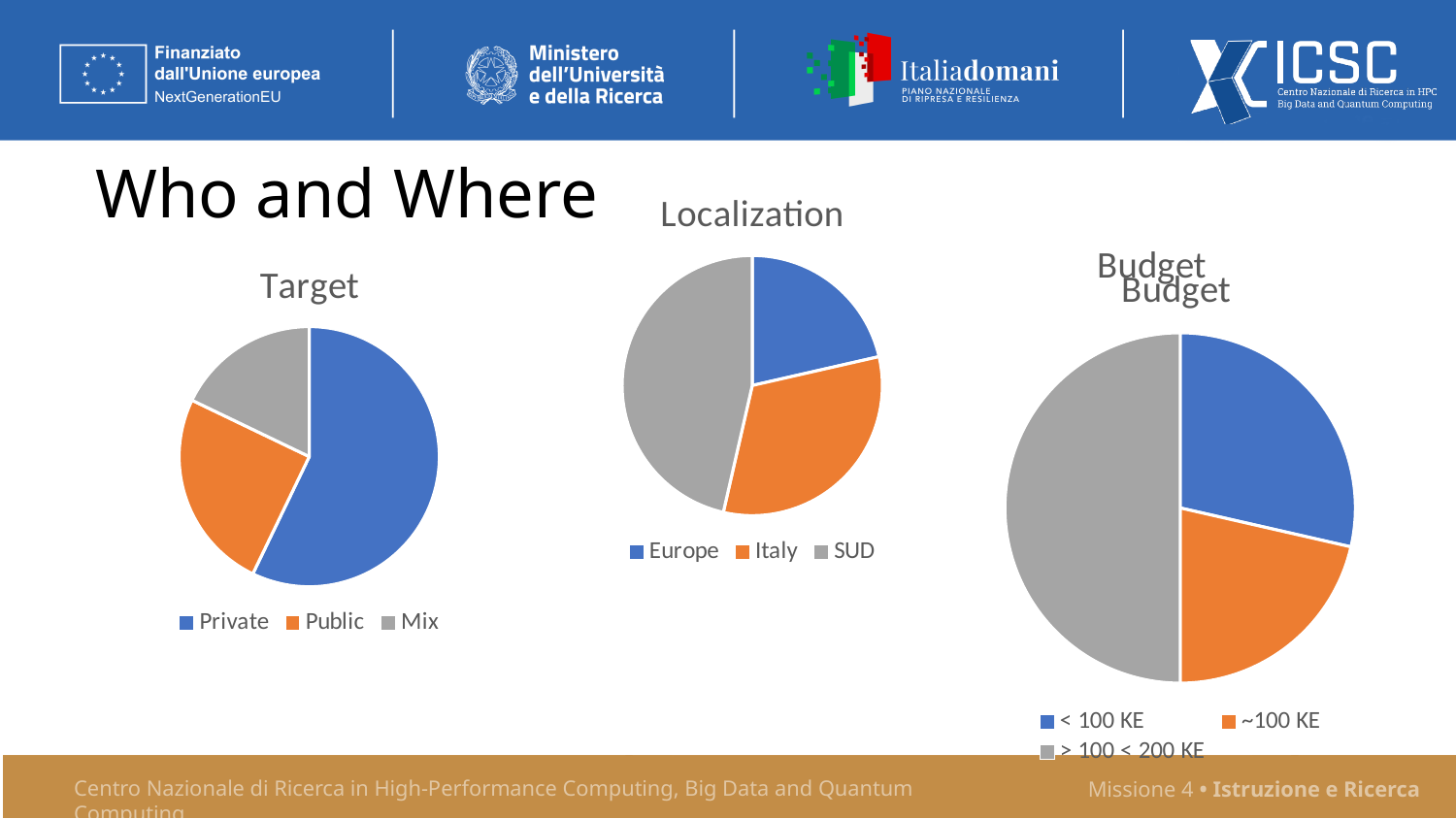
What are the legend entries of the Localization chart? Europe, Italy, SUD In the Localization chart, which slice is larger: Italy or Europe? Italy In the Target chart, which slice is larger: Public or Mix? Public In the Localization chart, which category has the smallest slice? Europe In the Budget chart, which slice is larger: < 100 KE or ~100 KE? < 100 KE How many slices does the Localization pie chart have? 3 In the Target chart, which category has the smallest slice? Mix How many entries does the legend of the Budget chart list? 3 In the Localization chart, which category has the largest slice? SUD What kind of chart is the Target chart? pie chart In the Budget chart, which category has the largest slice? > 100 < 200 KE In the Target chart, which category has the largest slice? Private